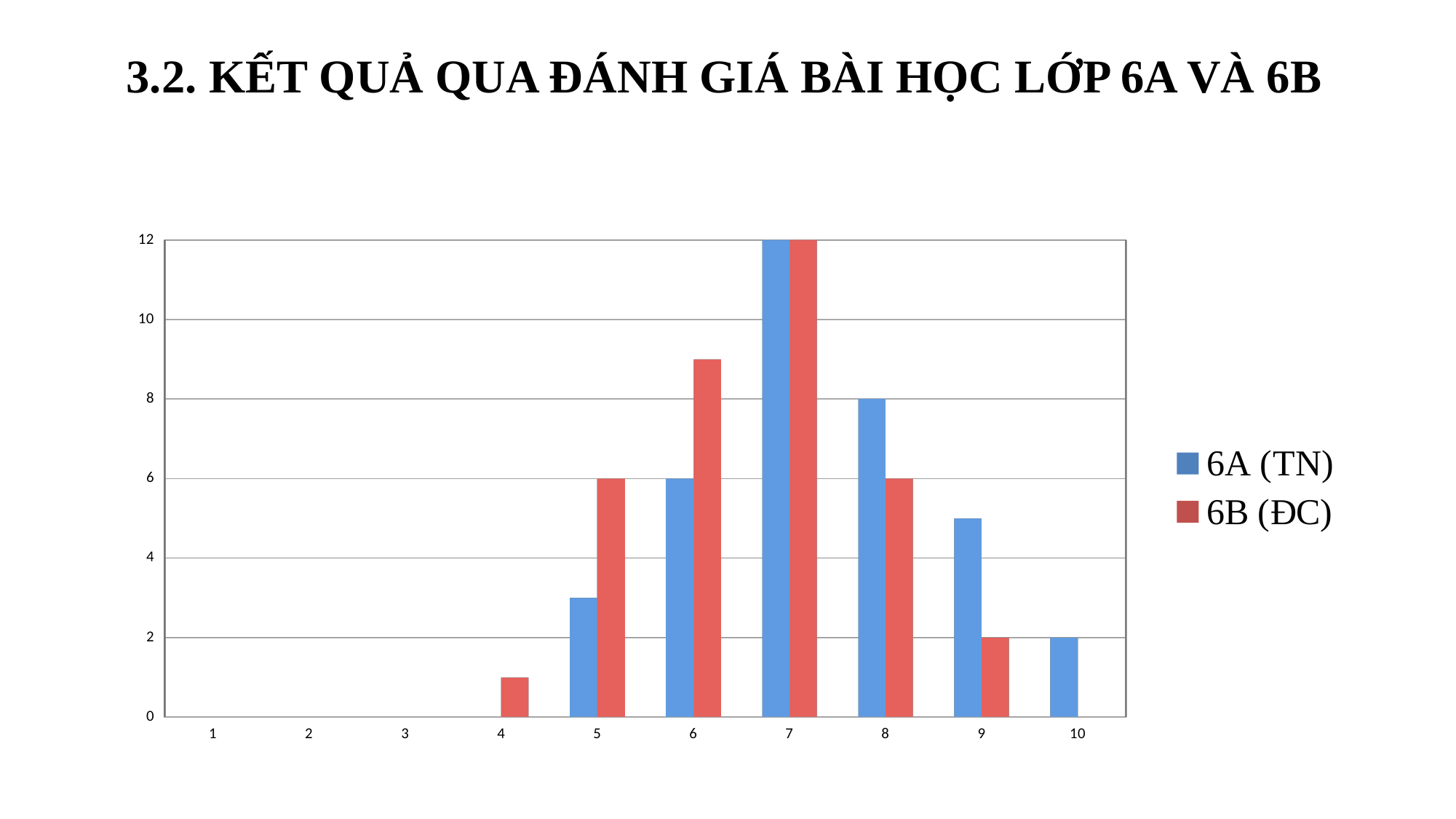
Which category has the highest value for 6A (TN)? 7 What is the value for 6B (ĐC) at category 5? 6 What is the value for 6A (TN) at category 8? 8 What kind of chart is shown on the slide? bar chart What is the difference between 6A (TN) and 6B (ĐC) at category 8? 2 What is the value for 6A (TN) at category 7? 12 Is the value for 6B (ĐC) at category 6 greater or less than 8? greater At category 6, which series has the larger value, 6A (TN) or 6B (ĐC)? 6B (ĐC) How many series does the legend list? 2 Is the value for 6A (TN) at category 5 greater or less than 4? less How many categories are shown on the x axis? 10 What is the value for 6B (ĐC) at category 9? 2